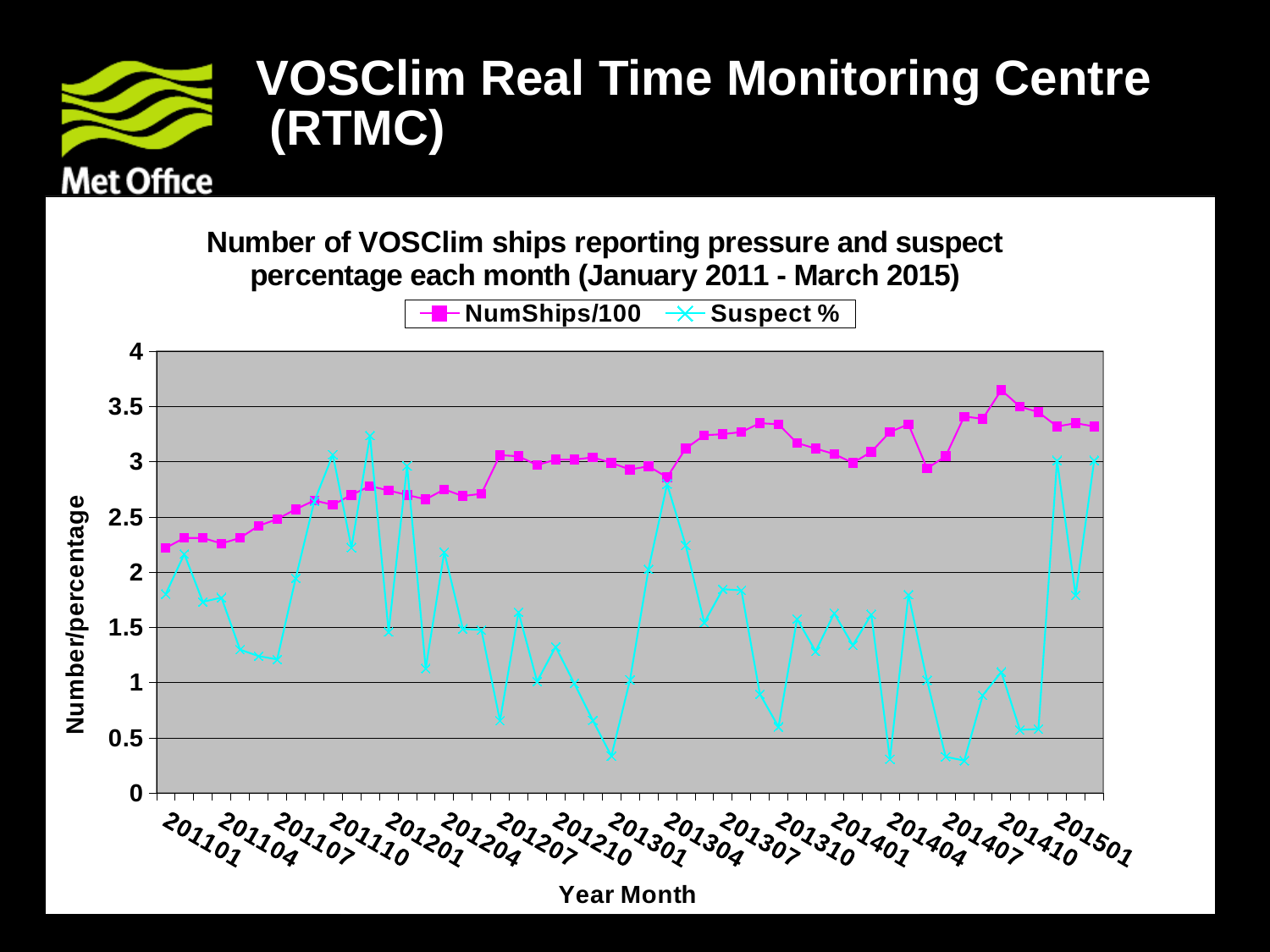
Is the value of NumShips/100 for 201501 greater or less than 3? greater Is the value of NumShips/100 for 201101 greater or less than 2? greater How many series does the legend list? 2 At 201101, which series has the larger value, NumShips/100 or Suspect %? NumShips/100 What are the two series named in the legend? NumShips/100 and Suspect % What kind of chart is shown on the slide? line chart Does the NumShips/100 series generally rise or fall from 201101 to 201501? rise Is the value of NumShips/100 for 201407 greater or less than 3.5? less What is the title of the y axis? Number/percentage At which month does the NumShips/100 series reach its highest value? 201410